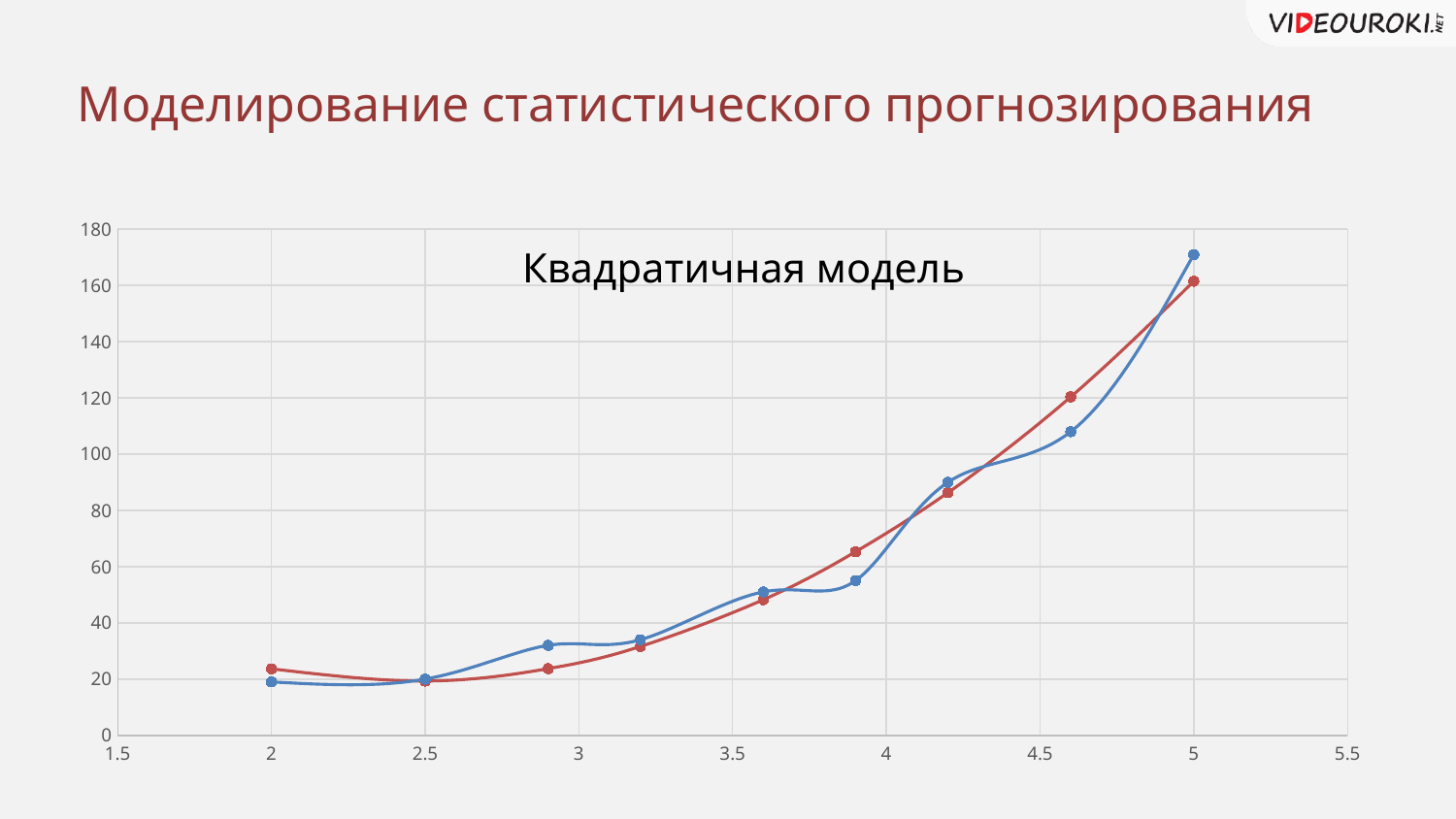
At x = 5, which series has the higher value, blue or red? blue At x = 4.6, which series has the higher value, blue or red? red At which x value does the blue series reach its highest point? 5 Do the values of the red series generally rise or fall as x increases from 2.5 to 5? rise Is the value of the red series at x = 2.9 greater or less than 40? less Is the value of the blue series at x = 3.9 greater or less than 60? less How many data points does the blue series have? 9 How many data series (lines) are plotted on the chart? 2 What kind of chart is shown on the slide? line chart Is the value of the red series at x = 3.9 greater or less than 60? greater What is the title shown on the chart? Квадратичная модель